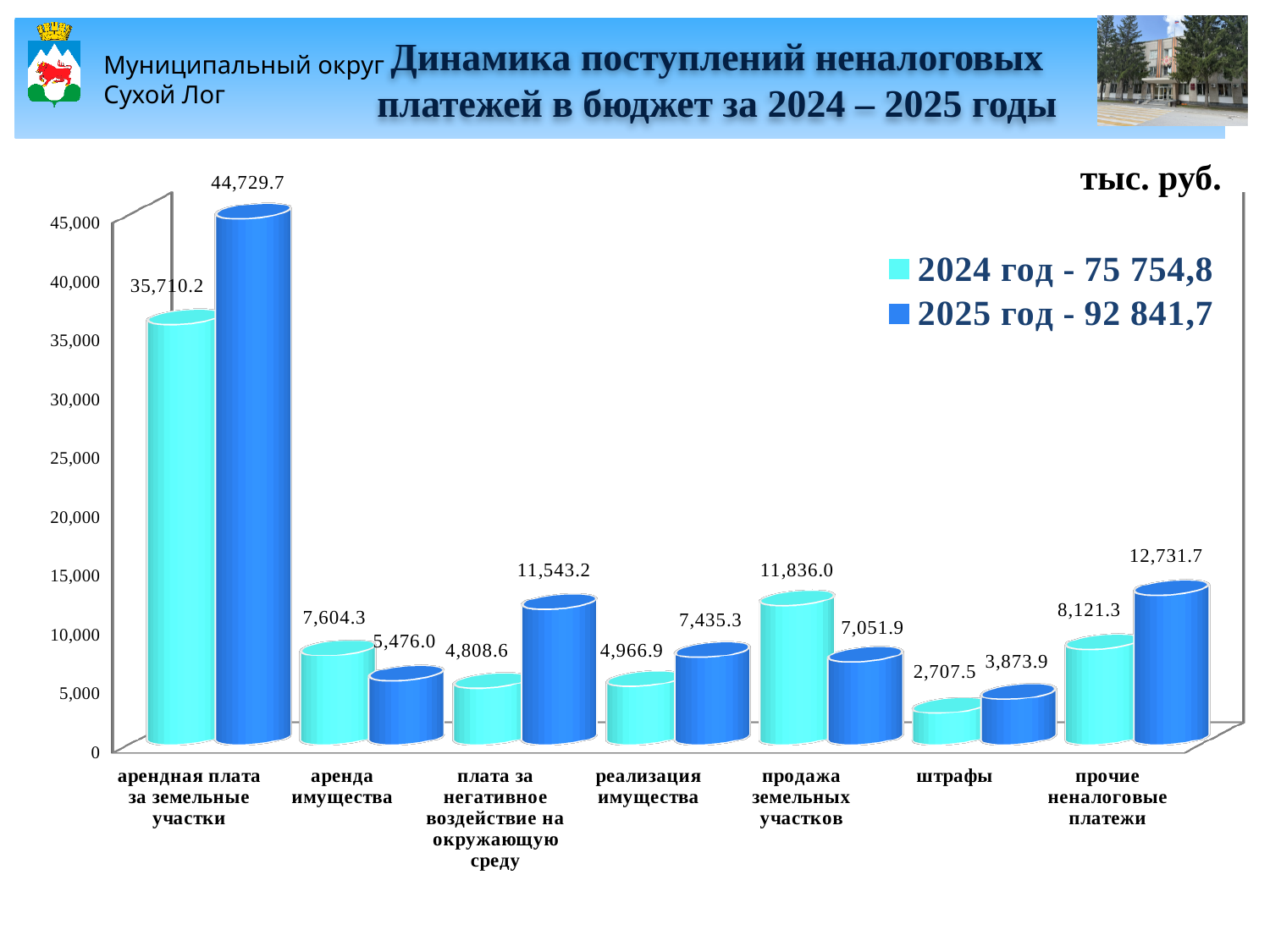
What is the difference between the 2025 год and 2024 год values for прочие неналоговые платежи? 4,610.4 What is the difference between the 2025 год and 2024 год values for плата за негативное воздействие на окружающую среду? 6,734.6 How many categories are shown on the x axis? 7 Which is larger for аренда имущества: the 2024 год value or the 2025 год value? 2024 год How many series does the legend list? 2 What is the 2024 год value for продажа земельных участков? 11,836.0 What is the 2025 год value for арендная плата за земельные участки? 44,729.7 Which category has the lowest 2025 год value? штрафы What is the 2025 год value for штрафы? 3,873.9 What type of chart is shown on the slide? bar chart Which category has the highest 2024 год value? арендная плата за земельные участки What total is shown in the legend entry for 2025 год? 92 841,7